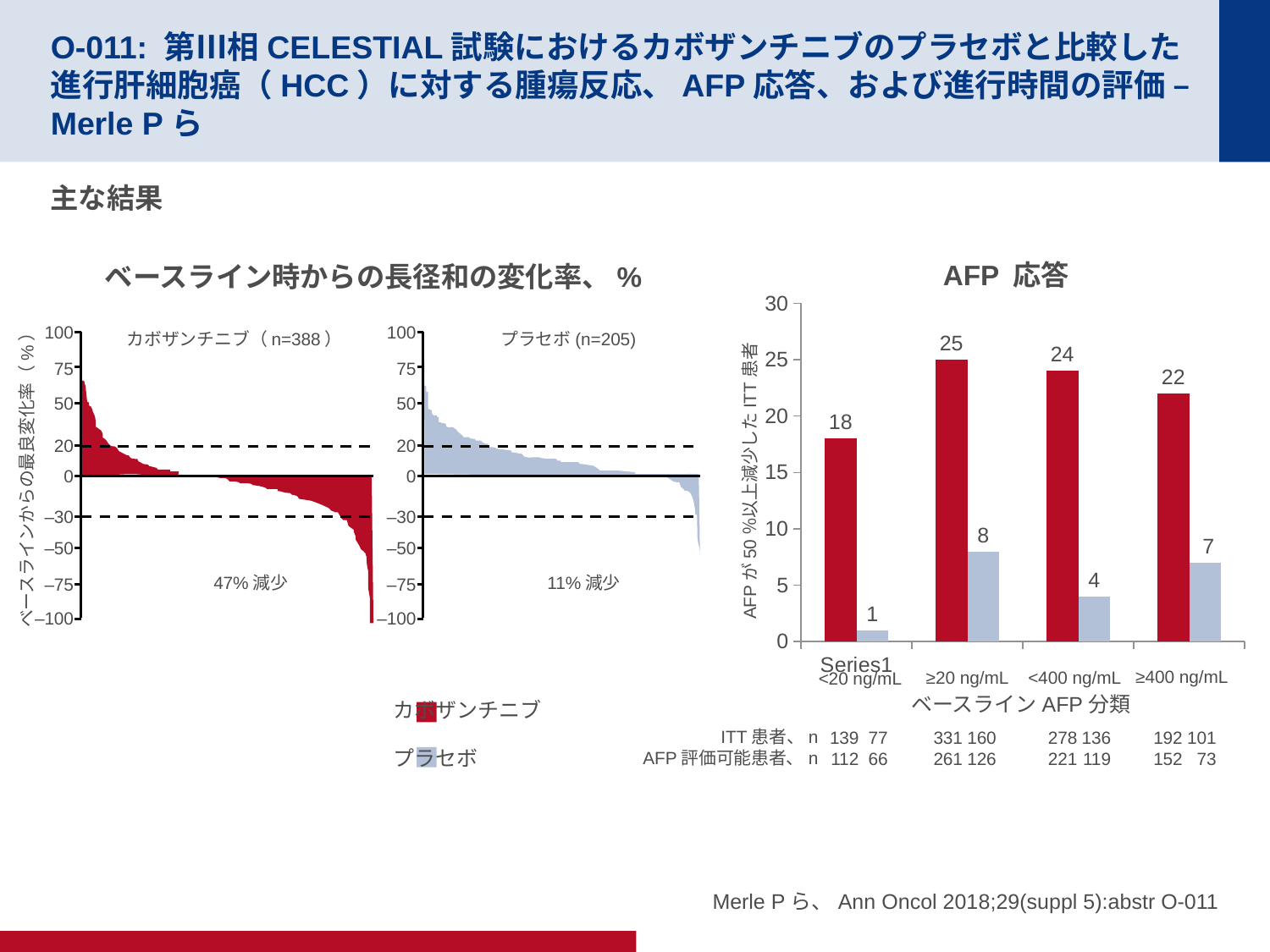
How many baseline AFP categories are shown on the x axis of the AFP 応答 chart? 4 In the AFP 応答 chart, what is the value for プラセボ in the <20 ng/mL category? 1 In the AFP 応答 chart, which baseline AFP category has the lowest value for プラセボ? <20 ng/mL How many series does the legend of the AFP 応答 chart list? 2 In the left waterfall chart for カボザンチニブ, what percentage reduction is annotated on the plot? 47% 減少 In the AFP 応答 chart, is the value for カボザンチニブ in the ≥400 ng/mL category greater or less than 20? greater What kind of chart is the AFP 応答 chart? bar chart In the AFP 応答 chart, which is larger: プラセボ in the ≥20 ng/mL category or プラセボ in the <400 ng/mL category? ≥20 ng/mL In the AFP 応答 chart, what is the value for プラセボ in the ≥400 ng/mL category? 7 In the AFP 応答 chart, what is the value for カボザンチニブ in the ≥20 ng/mL category? 25 In the AFP 応答 chart, which baseline AFP category has the highest value for カボザンチニブ? ≥20 ng/mL In the AFP 応答 chart, what is the difference between カボザンチニブ and プラセボ in the <400 ng/mL category? 20